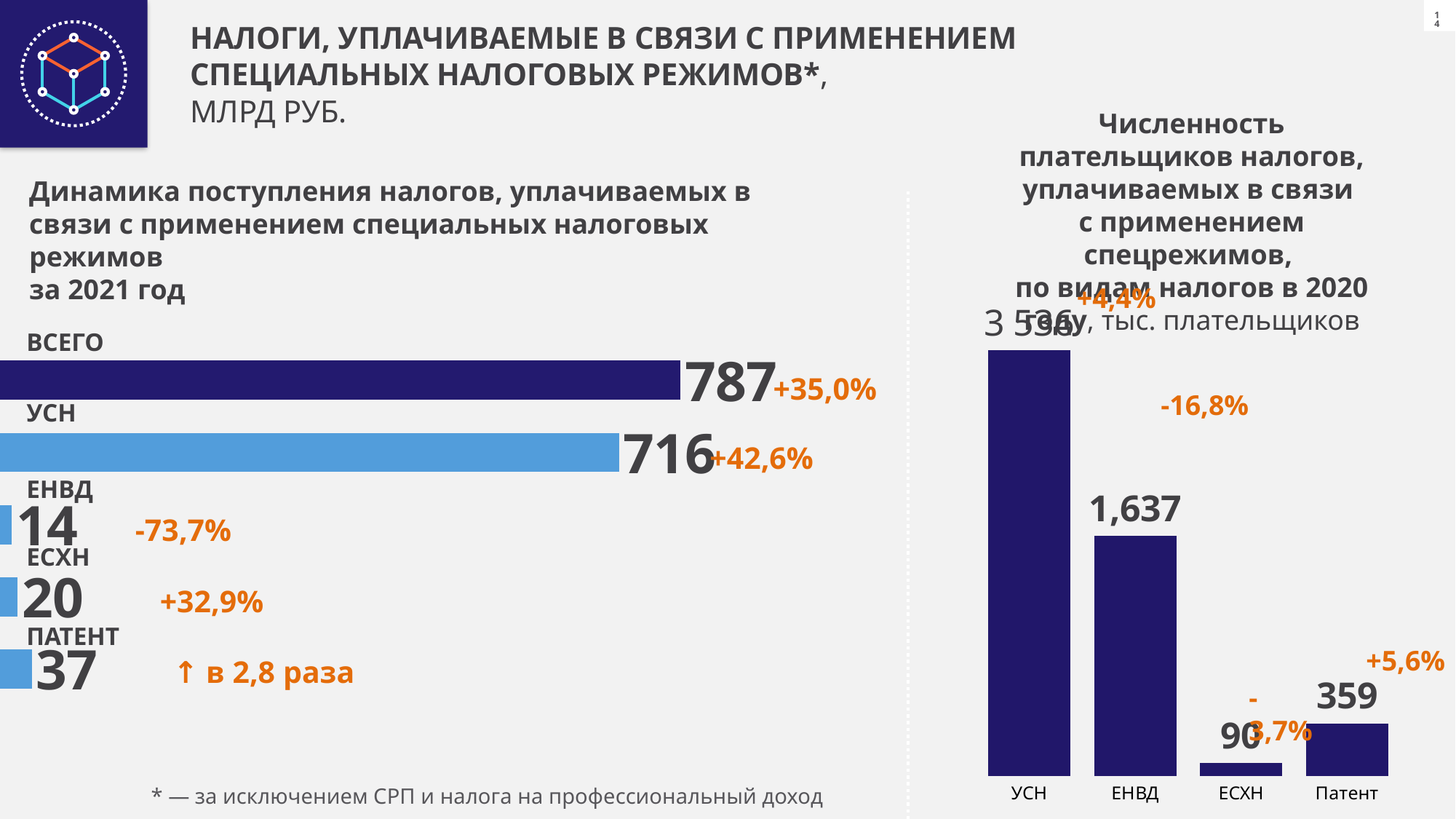
In the right chart (Численность плательщиков налогов), which category has the highest value? УСН What kind of chart is the right chart (Численность плательщиков налогов)? Bar chart In the left chart (Динамика поступления налогов), what is the value for УСН? 716 In the left chart (Динамика поступления налогов), what is the value for ВСЕГО? 787 In the left chart (Динамика поступления налогов), what is the value for ПАТЕНТ? 37 In the left chart (Динамика поступления налогов), what percentage change is shown for ЕНВД? -73,7% In the right chart (Численность плательщиков налогов), what is the value for ЕНВД? 1,637 In the right chart (Численность плательщиков налогов), what is the value for Патент? 359 In the left chart (Динамика поступления налогов), which is larger, the value for ПАТЕНТ or the value for ЕСХН? ПАТЕНТ In the right chart (Численность плательщиков налогов), how many categories are shown? 4 In the left chart (Динамика поступления налогов), which category other than ВСЕГО has the lowest value? ЕНВД In the left chart (Динамика поступления налогов), what is the difference between the values for ЕСХН and ЕНВД? 6